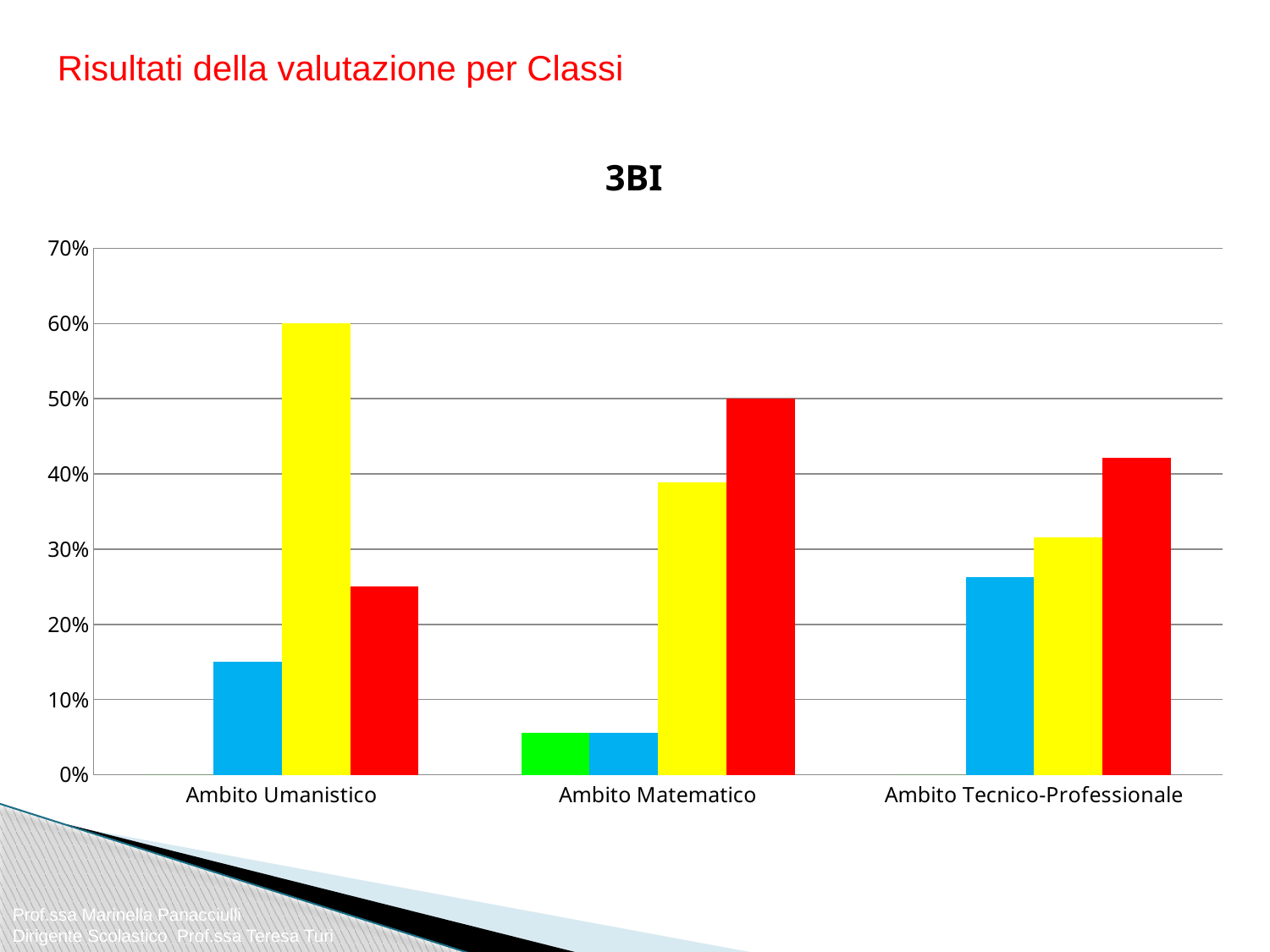
What kind of chart is shown on the slide? bar chart How many categories are shown on the x axis of the chart? 3 Which is larger for Ambito Matematico, the yellow bar or the red bar? the red bar Is the value of the red bar for Ambito Tecnico-Professionale greater or less than 40%? greater What is the value of the red bar for Ambito Matematico? 50% Which category has the lowest blue bar? Ambito Matematico Is the value of the yellow bar for Ambito Tecnico-Professionale greater or less than 30%? greater Is the value of the blue bar for Ambito Umanistico greater or less than 20%? less Which category has the tallest yellow bar? Ambito Umanistico What is the title of the chart? 3BI What is the value of the yellow bar for Ambito Umanistico? 60%